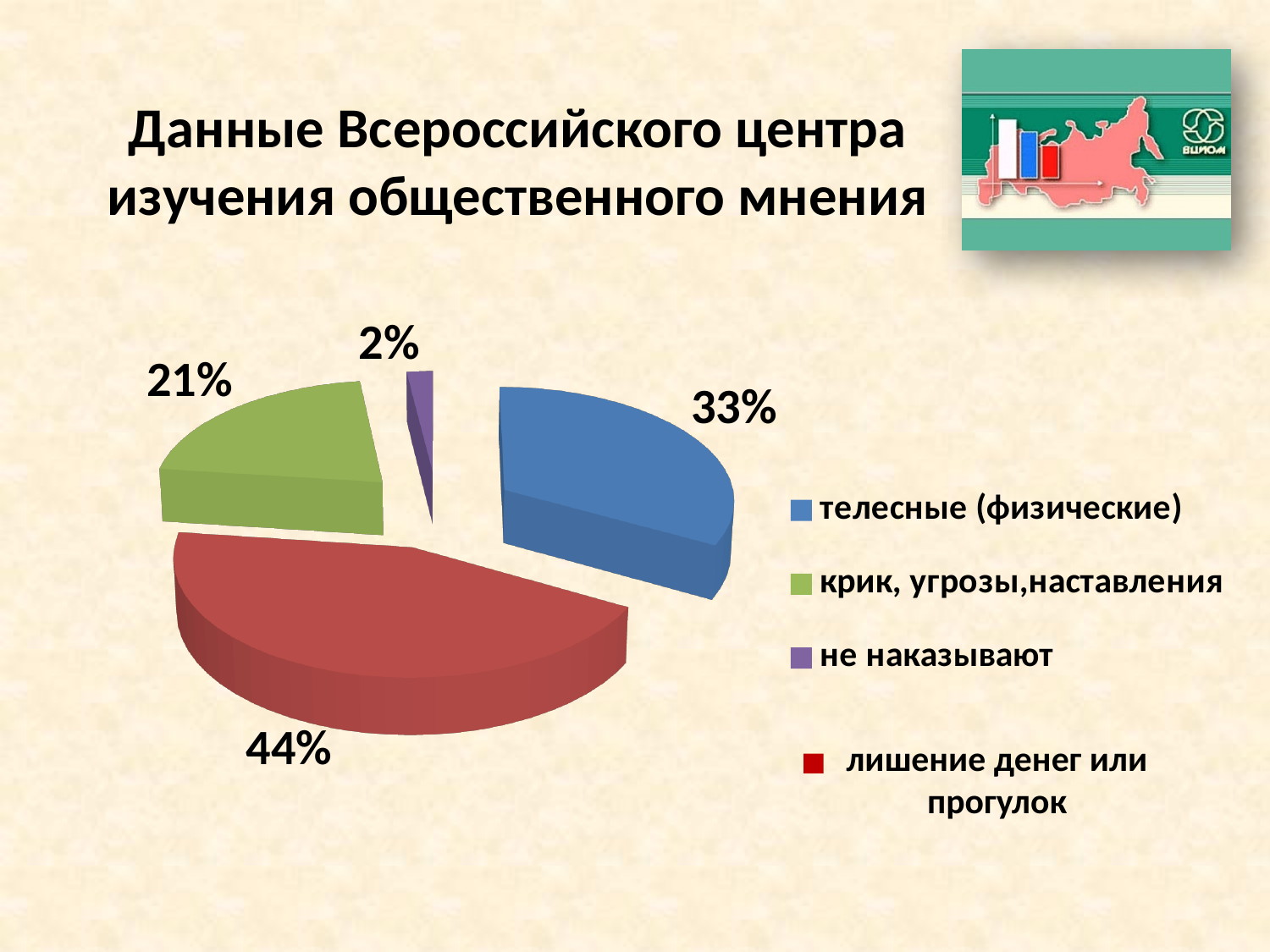
What is the title of the slide containing the chart? Данные Всероссийского центра изучения общественного мнения What percentage is shown for the slice "крик, угрозы, наставления"? 21% Which category has the smallest slice of the pie? не наказывают Which is larger: the slice for "телесные (физические)" or the slice for "крик, угрозы, наставления"? телесные (физические) What colour is the slice for "не наказывают"? purple What kind of chart is shown on the slide? pie chart What percentage is shown for the slice "не наказывают"? 2% How many slices does the pie chart have? 4 What is the difference in percentage points between "лишение денег или прогулок" and "телесные (физические)"? 11 What percentage is shown for the slice "лишение денег или прогулок"? 44% What percentage is shown for the slice "телесные (физические)"? 33% Which category has the largest slice of the pie? лишение денег или прогулок